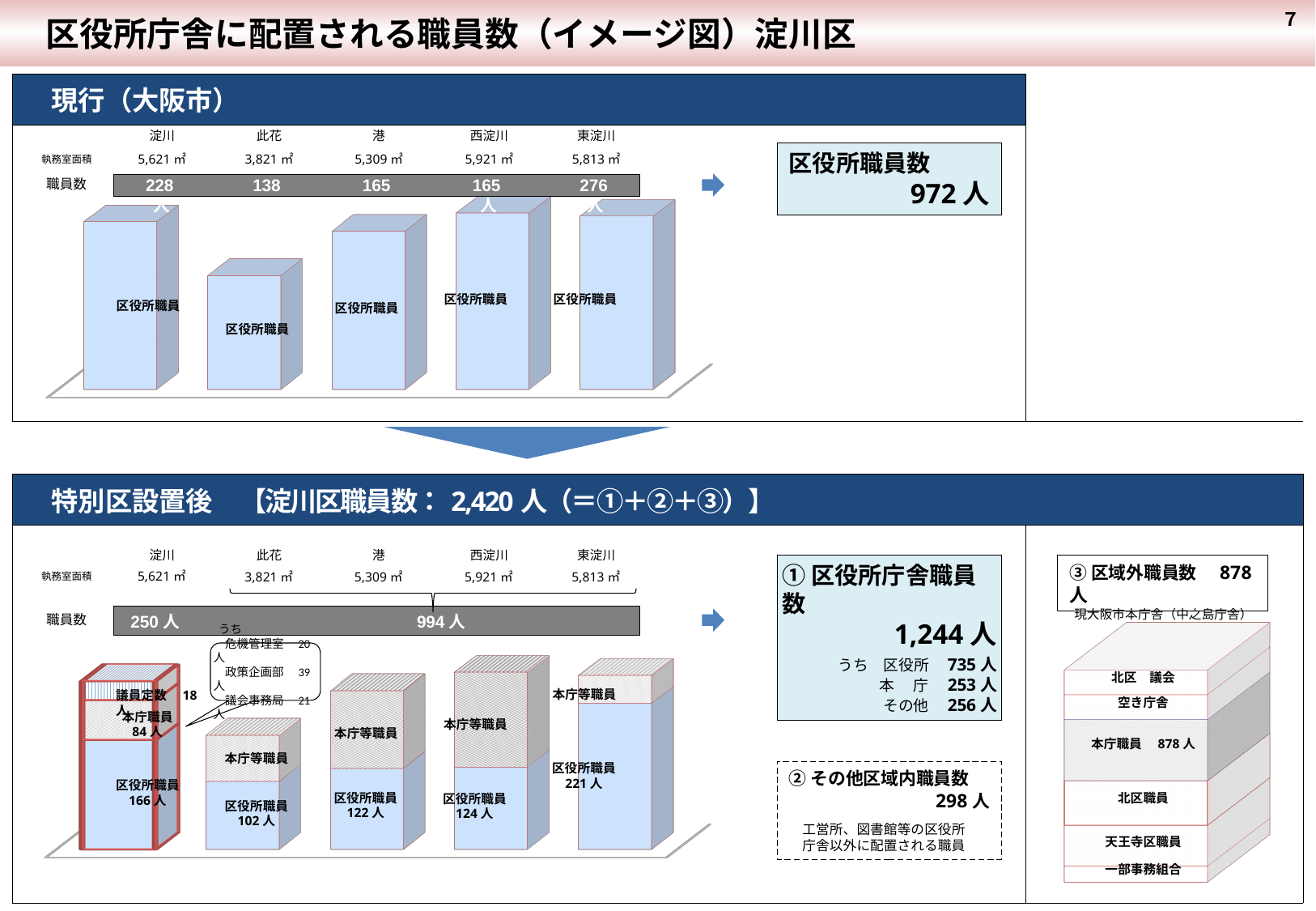
In the top chart (現行（大阪市）), what is the 職員数 value for 東淀川? 276 In the top chart (現行（大阪市）), which ward has the highest 職員数? 東淀川 In the bottom chart (特別区設置後), what is the total 職員数 shown for 淀川 in the gray bar? 250 人 In the top chart (現行（大阪市）), which ward has the lowest 職員数? 此花 In the top chart (現行（大阪市）), which has the larger 職員数, 淀川 or 此花? 淀川 In the bottom chart (特別区設置後), what is the difference in 区役所職員 between 東淀川 and 此花? 119 人 In the bottom chart (特別区設置後), what is the 区役所職員 value for 港? 122 人 In the bottom chart (特別区設置後), which ward has the highest 区役所職員 value? 東淀川 In the top chart (現行（大阪市）), what is the total 区役所職員数 shown in the box on the right? 972 人 In the top chart (現行（大阪市）), how many wards are shown? 5 In the top chart (現行（大阪市）), what is the difference in 職員数 between 東淀川 and 此花? 138 In the bottom chart (特別区設置後), what is the 本庁職員 value shown for 淀川? 84 人